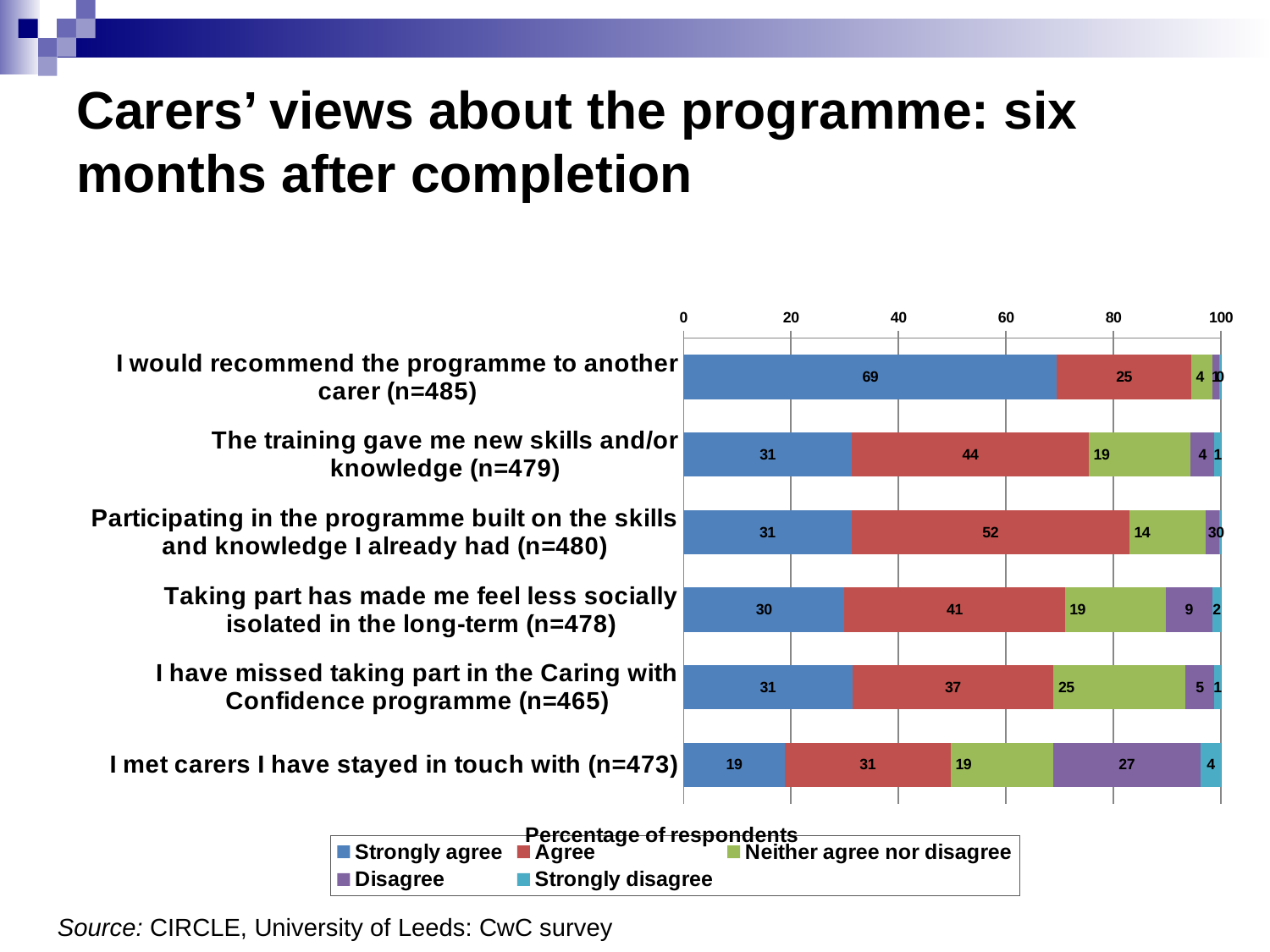
What percentage of respondents agree with "The training gave me new skills and/or knowledge (n=479)"? 44 What percentage of respondents strongly agree with "I would recommend the programme to another carer (n=485)"? 69 Which statement has the lowest Strongly agree percentage? I met carers I have stayed in touch with (n=473) Which has a larger Agree value: "Taking part has made me feel less socially isolated in the long-term (n=478)" or "I have missed taking part in the Caring with Confidence programme (n=465)"? Taking part has made me feel less socially isolated in the long-term (n=478) How many statements are shown on the chart? 6 What is the Agree value for "Participating in the programme built on the skills and knowledge I already had (n=480)"? 52 What kind of chart is shown on the slide? Stacked bar chart How many series does the legend list? 5 What is the Disagree value for "I met carers I have stayed in touch with (n=473)"? 27 Which statement has the highest Agree percentage? Participating in the programme built on the skills and knowledge I already had (n=480) Which statement has the highest Strongly agree percentage? I would recommend the programme to another carer (n=485) What is the difference between the Strongly agree values for "I would recommend the programme to another carer (n=485)" and "The training gave me new skills and/or knowledge (n=479)"? 38